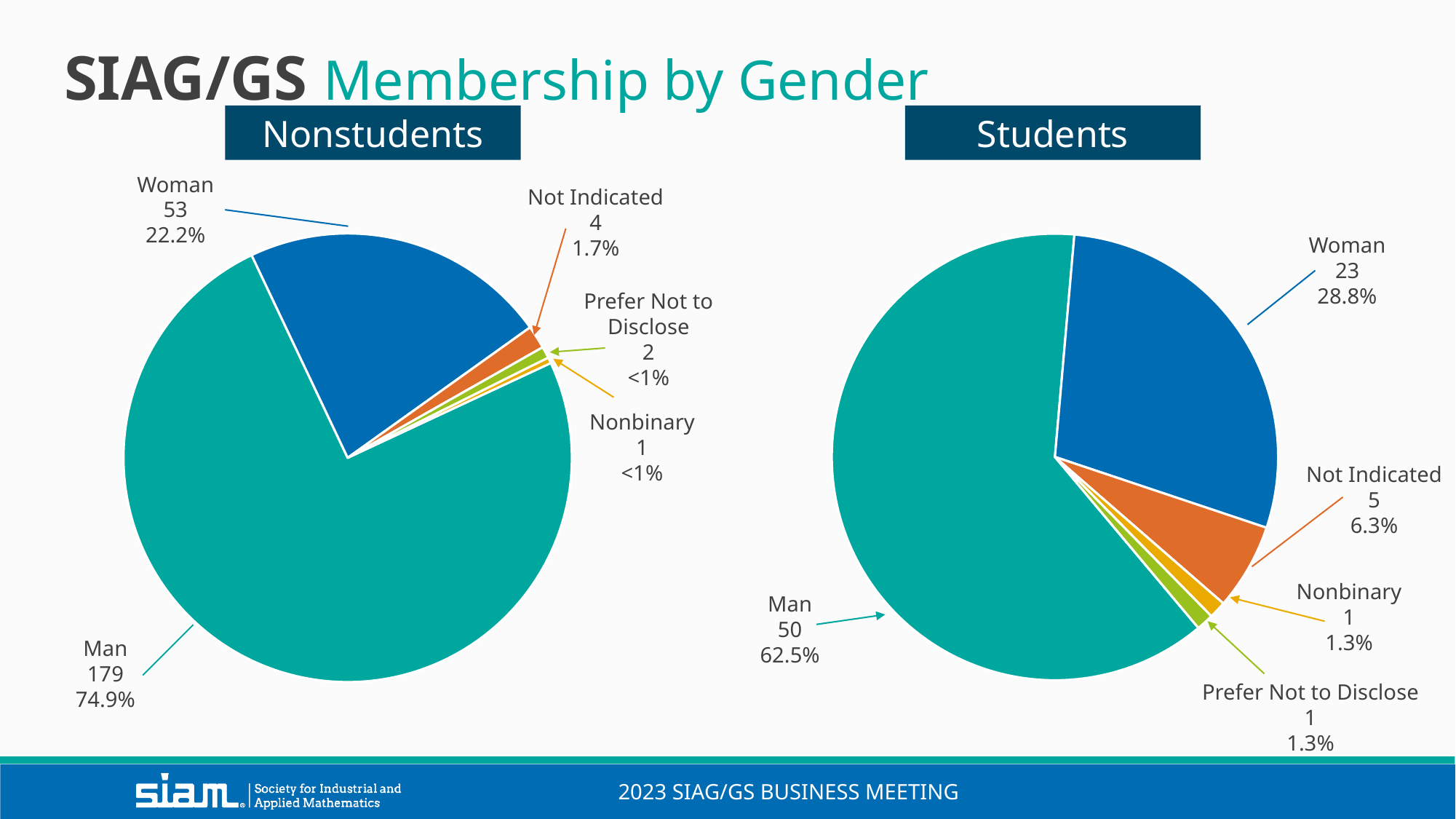
In the Nonstudents chart, what is the difference between the number of Man and Woman members? 126 How many categories does the Nonstudents chart show? 5 In the Nonstudents chart, how many members are Not Indicated? 4 In the Students chart, what is the difference between the number of Woman and Not Indicated members? 18 In the Nonstudents chart, which category has the largest slice? Man What kind of chart is the Students chart? Pie chart In the Students chart, what percentage of members are Man? 62.5% In the Students chart, what share of the pie is Woman? 28.8% In the Students chart, which category has the largest slice? Man In the Students chart, which is larger, Not Indicated or Nonbinary? Not Indicated What is the title of the slide? SIAG/GS Membership by Gender In the Nonstudents chart, how many members are Woman? 53